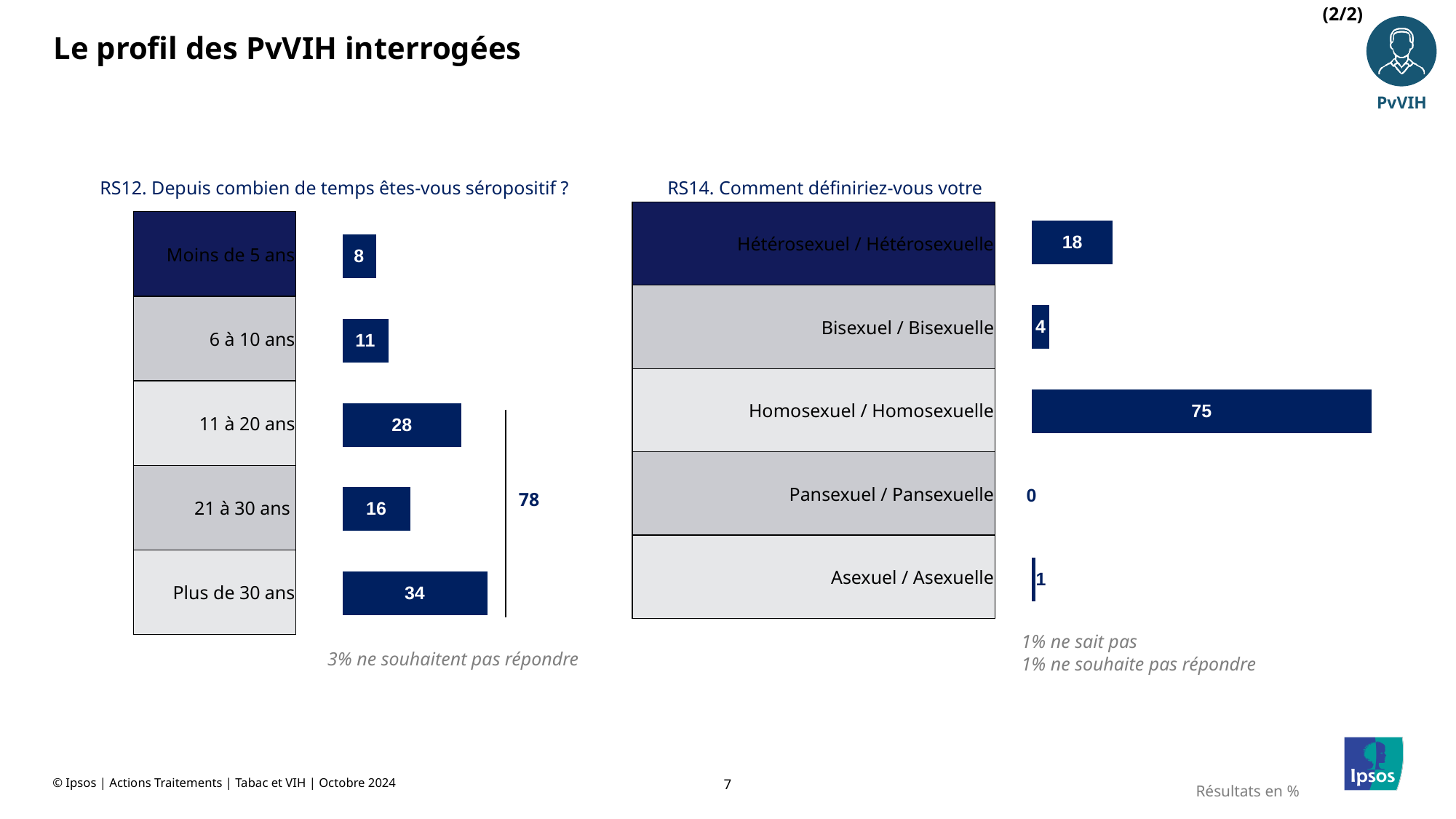
In the RS12 chart on the left, what is the difference between "11 à 20 ans" and "21 à 30 ans"? 12 In the RS14 chart on the right, which is larger: "Hétérosexuel / Hétérosexuelle" or "Bisexuel / Bisexuelle"? Hétérosexuel / Hétérosexuelle In the RS14 chart on the right, what is the value for "Bisexuel / Bisexuelle"? 4 In the RS12 chart on the left, what combined value is shown by the bracket grouping the last three categories? 78 In the RS12 chart on the left, what is the value for "6 à 10 ans"? 11 In the RS12 chart on the left, what is the value for "Plus de 30 ans"? 34 In the RS12 chart on the left, which category has the highest value? Plus de 30 ans What type of chart is the RS14 chart on the right? Bar chart In the RS12 chart on the left, which category has the lowest value? Moins de 5 ans In the RS14 chart on the right, what is the value for "Homosexuel / Homosexuelle"? 75 In the RS12 chart on the left, how many categories are shown? 5 In the RS14 chart on the right, which category has the lowest value? Pansexuel / Pansexuelle